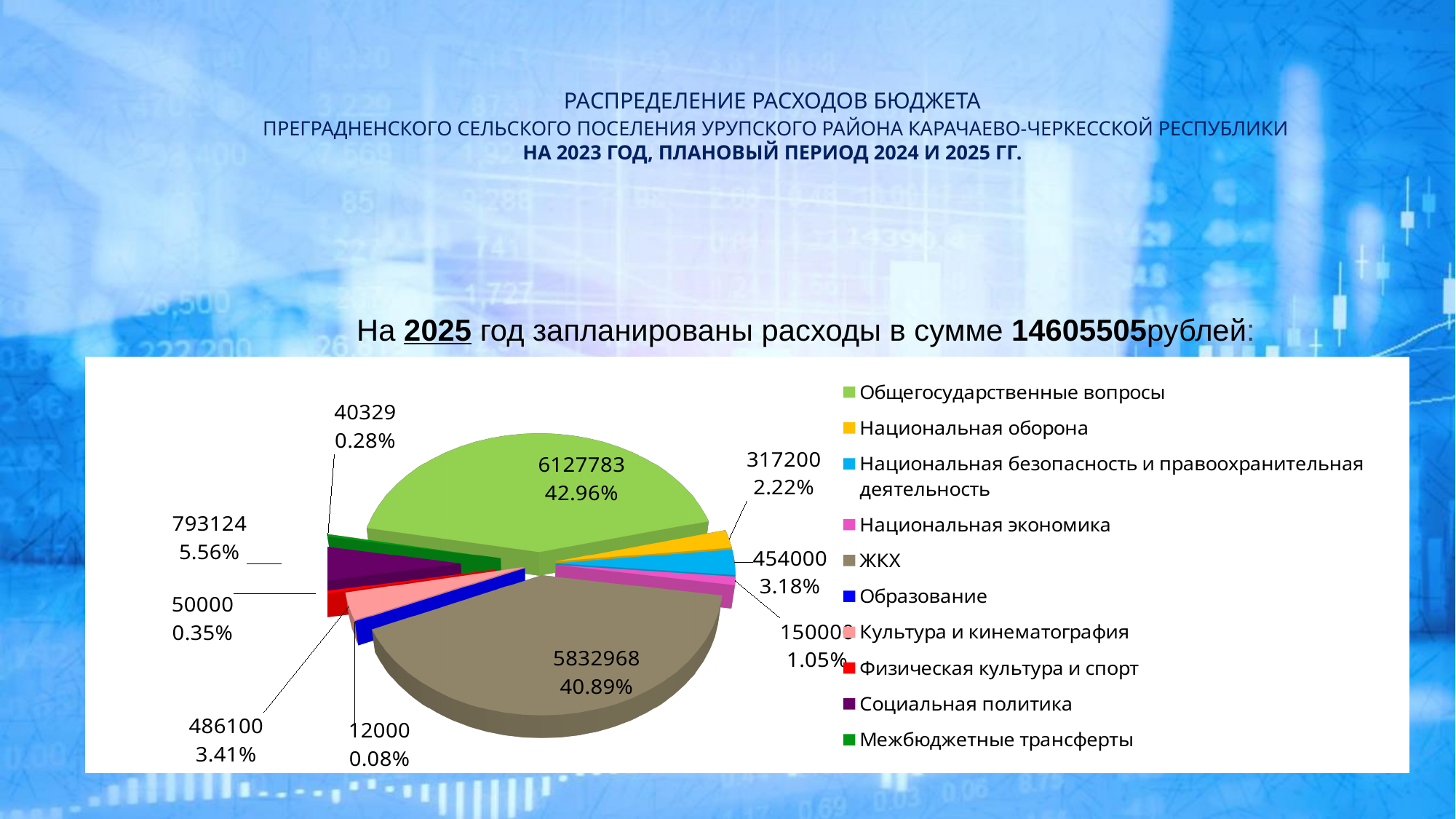
What is the value shown for Общегосударственные вопросы? 6127783 Which category has the smallest slice of the pie? Образование What total planned expenditure for 2025 is stated above the chart? 14605505 Which category has the largest slice of the pie? Общегосударственные вопросы What is the value shown for Социальная политика? 793124 What kind of chart is shown on the slide? pie chart What share of the pie does ЖКХ represent? 40.89% Which is larger, the value for Культура и кинематография or the value for Национальная оборона? Культура и кинематография What is the value shown for Межбюджетные трансферты? 40329 How many categories does the legend of the pie chart list? 10 What is the difference between the values for Общегосударственные вопросы and ЖКХ? 294815 What percentage is shown for Национальная безопасность и правоохранительная деятельность? 3.18%